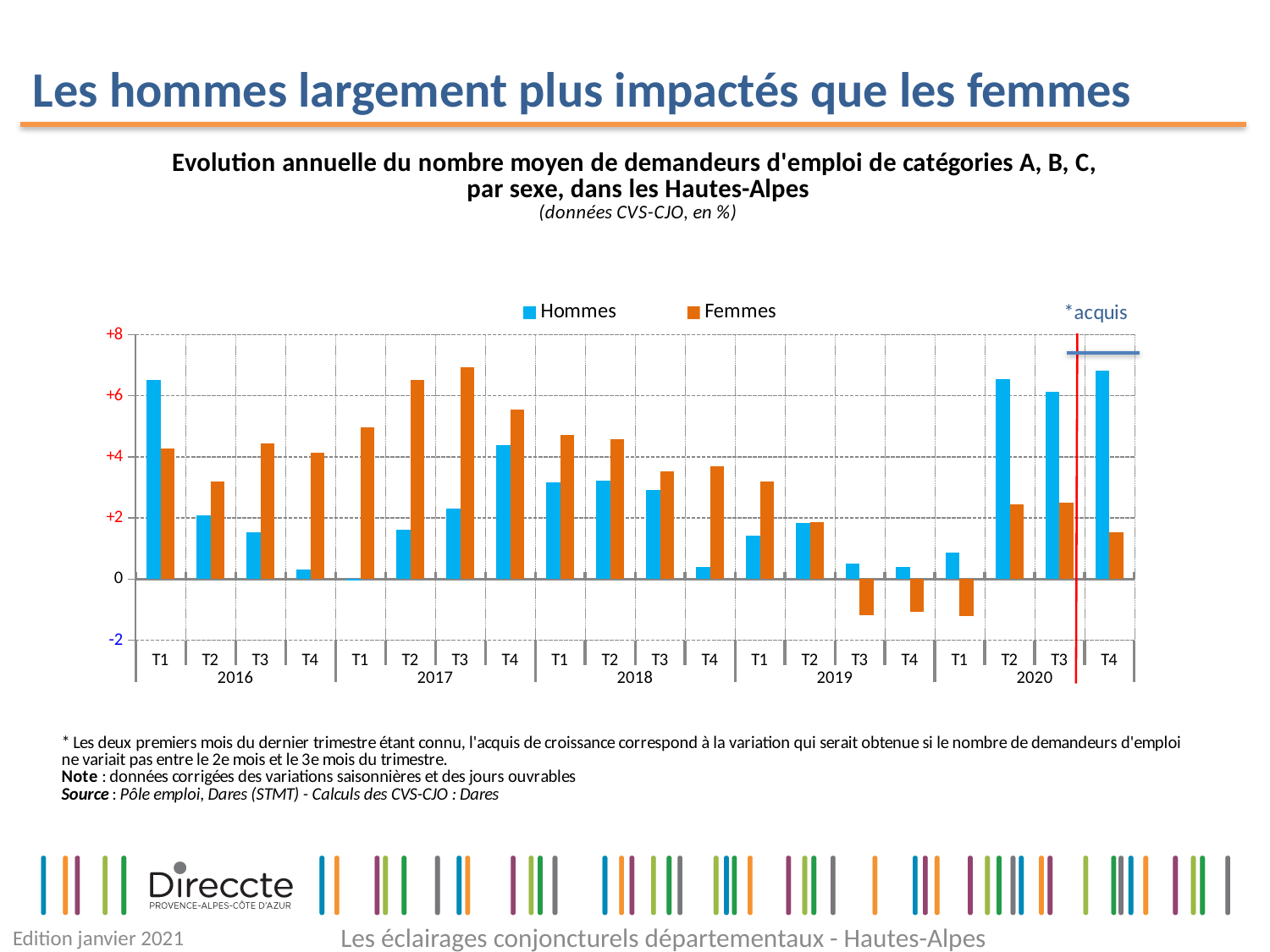
Is the value for Hommes in T4 2020 greater or less than +6? greater Which colour represents the Hommes series in the legend? blue In how many quarters is the Femmes value negative? 3 In T2 2020, which series has the larger value, Hommes or Femmes? Hommes Is the value for Femmes in T3 2017 greater or less than +6? greater How many series does the legend list? 2 Do the Hommes values rise or fall from T1 2016 to T4 2016? fall In T2 2017, which series has the larger value, Hommes or Femmes? Femmes What kind of chart is shown on the slide? bar chart Is the value for Hommes in T4 2016 greater or less than +2? less In which quarter does the Femmes series reach its highest value? T3 2017 How many quarters are plotted along the x axis? 20